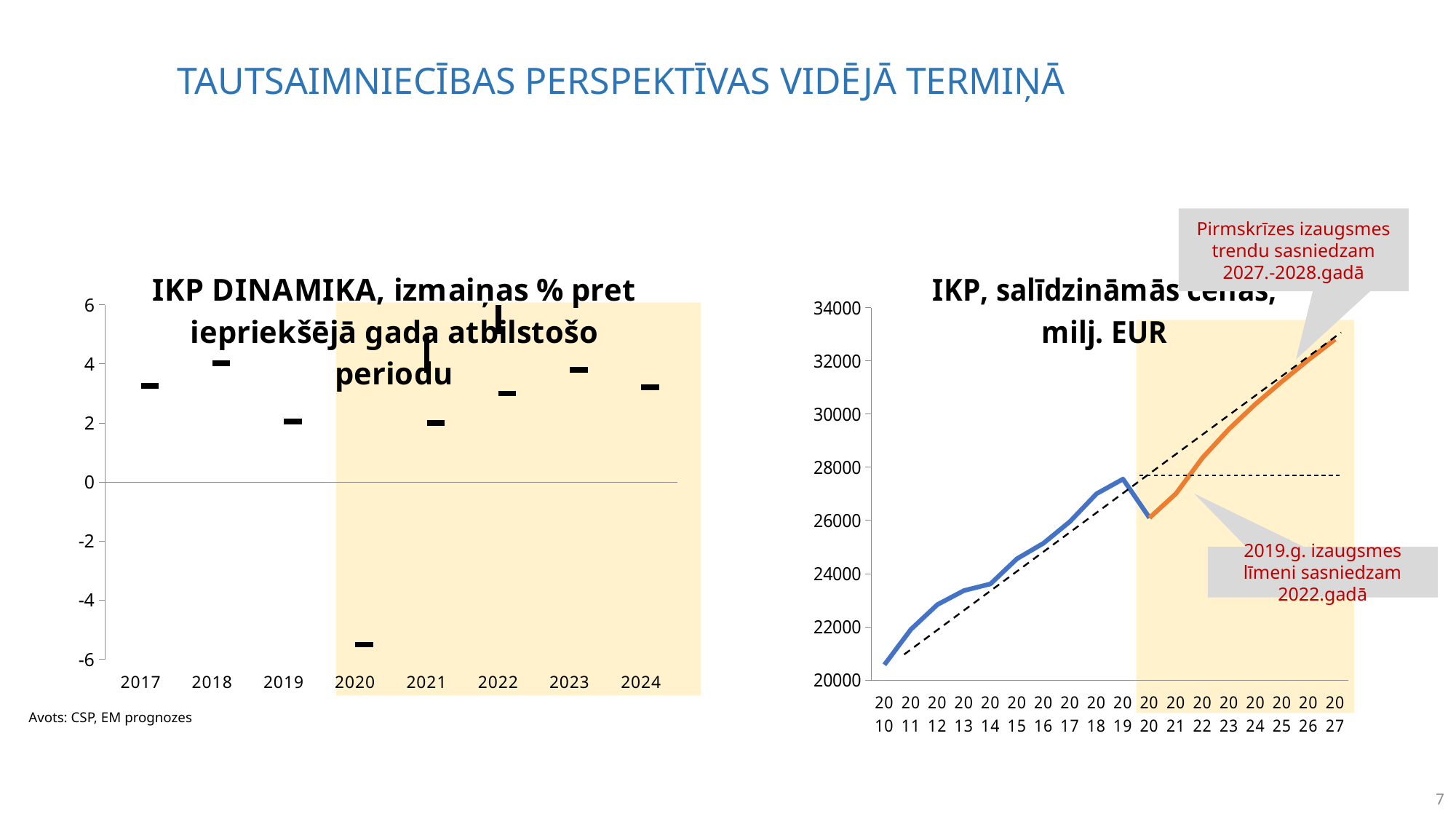
What kind of chart is the right chart (IKP, salīdzināmās cenas, milj. EUR)? line chart In the right chart (IKP, salīdzināmās cenas, milj. EUR), which year has the highest value? 2027 In the right chart (IKP, salīdzināmās cenas, milj. EUR), is the value for 2010 greater or less than 22000? less What source is cited at the bottom left of the slide? Avots: CSP, EM prognozes In the left chart (IKP DINAMIKA), is the value for 2020 greater or less than -4? less In the right chart (IKP, salīdzināmās cenas, milj. EUR), which year has the lowest value? 2010 In the left chart (IKP DINAMIKA), which is larger, the value for 2019 or the value for 2020? 2019 How many years are shown on the x axis of the left chart (IKP DINAMIKA)? 8 In the left chart (IKP DINAMIKA), which year has the lowest value? 2020 How many years are shown on the x axis of the right chart (IKP, salīdzināmās cenas, milj. EUR)? 18 In the right chart (IKP, salīdzināmās cenas, milj. EUR), which is larger, the value for 2019 or the value for 2020? 2019 In the left chart (IKP DINAMIKA), is the value for 2017 greater or less than 2? greater